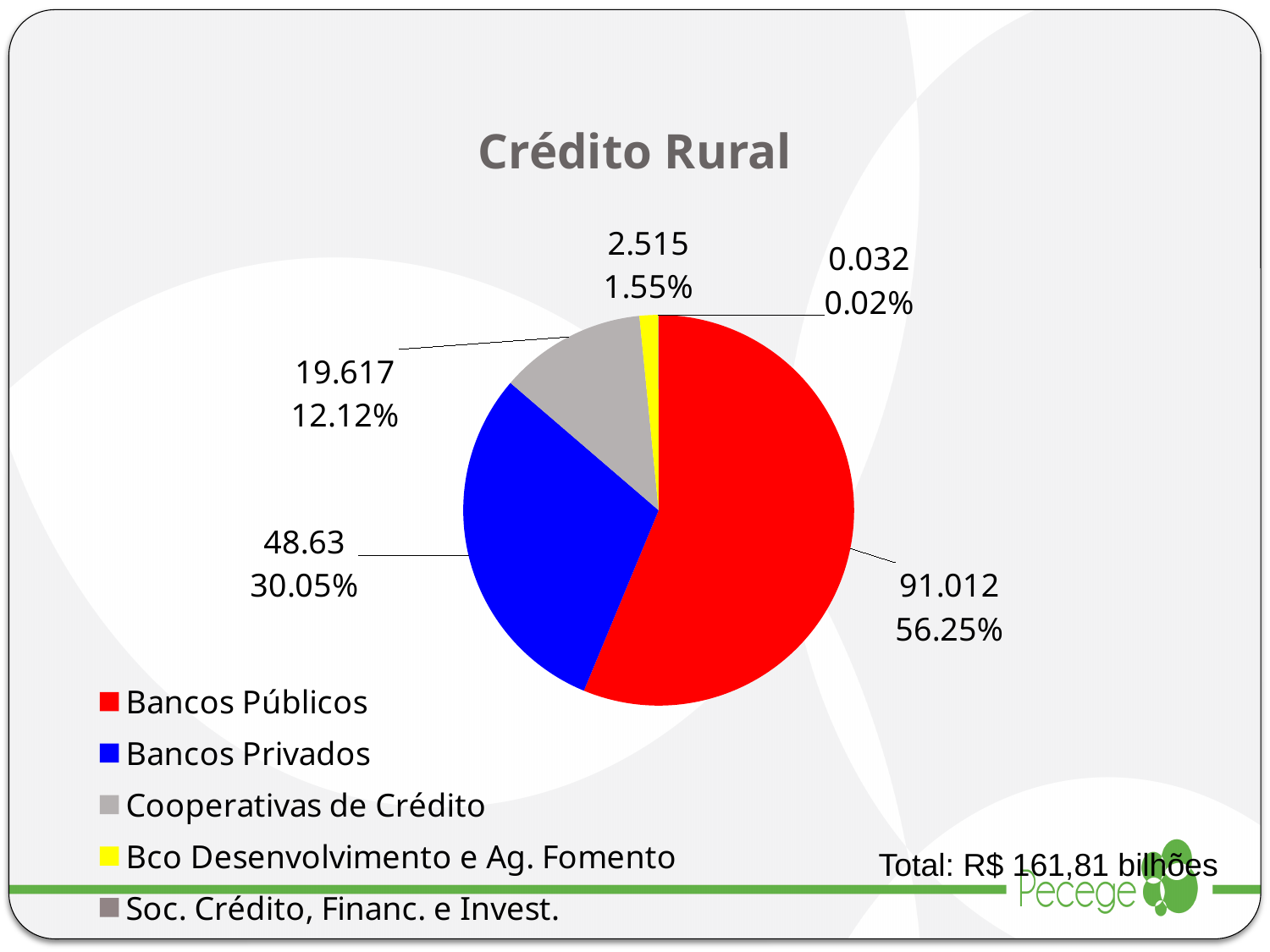
Which category has the largest slice of the pie? Bancos Públicos How many entries does the legend list? 5 What percentage share does Bancos Privados have? 30.05% What percentage share does Bco Desenvolvimento e Ag. Fomento have? 1.55% Which category has the smallest slice of the pie? Soc. Crédito, Financ. e Invest. What value is shown for Bancos Públicos? 91.012 What value is shown for Cooperativas de Crédito? 19.617 What kind of chart is shown on the slide? Pie chart What colour is the slice for Bancos Privados? Blue What value is shown for Soc. Crédito, Financ. e Invest.? 0.032 Which is larger, the share of Bancos Privados or the share of Cooperativas de Crédito? Bancos Privados What is the title of the chart? Crédito Rural